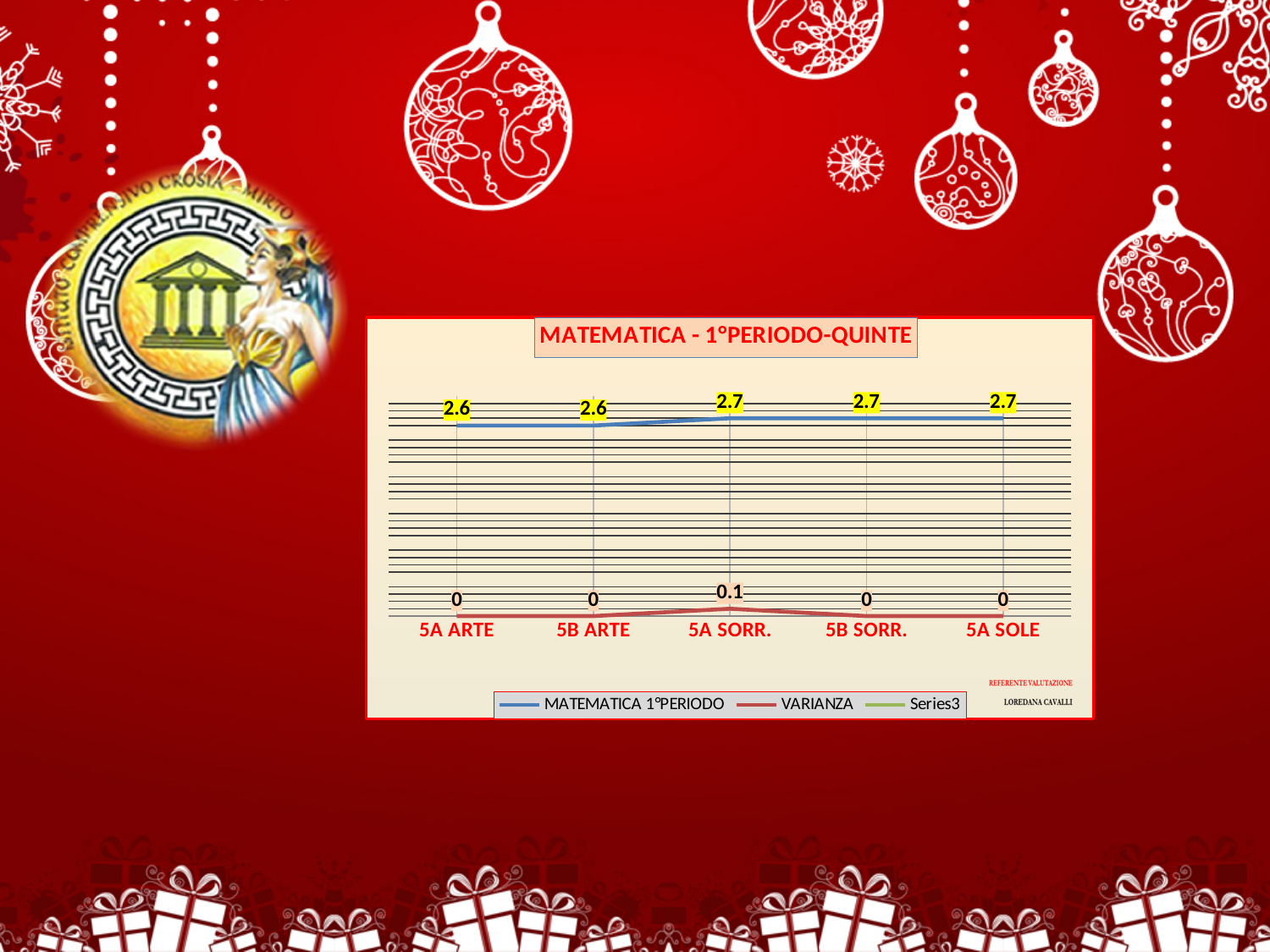
What is the VARIANZA value for 5A SORR.? 0.1 What kind of chart is shown on the slide? line chart How many series does the legend list? 3 What is the difference between the MATEMATICA 1°PERIODO values for 5A SORR. and 5B ARTE? 0.1 Does the MATEMATICA 1°PERIODO line rise or fall from 5A ARTE to 5A SOLE? rise What is the MATEMATICA 1°PERIODO value for 5A ARTE? 2.6 How many categories are shown on the x axis? 5 Which category has the highest VARIANZA value? 5A SORR. What is the title of the chart? MATEMATICA - 1°PERIODO-QUINTE What is the MATEMATICA 1°PERIODO value for 5A SOLE? 2.7 What is the VARIANZA value for 5B SORR.? 0 Which is larger, the MATEMATICA 1°PERIODO value for 5B ARTE or for 5B SORR.? 5B SORR.